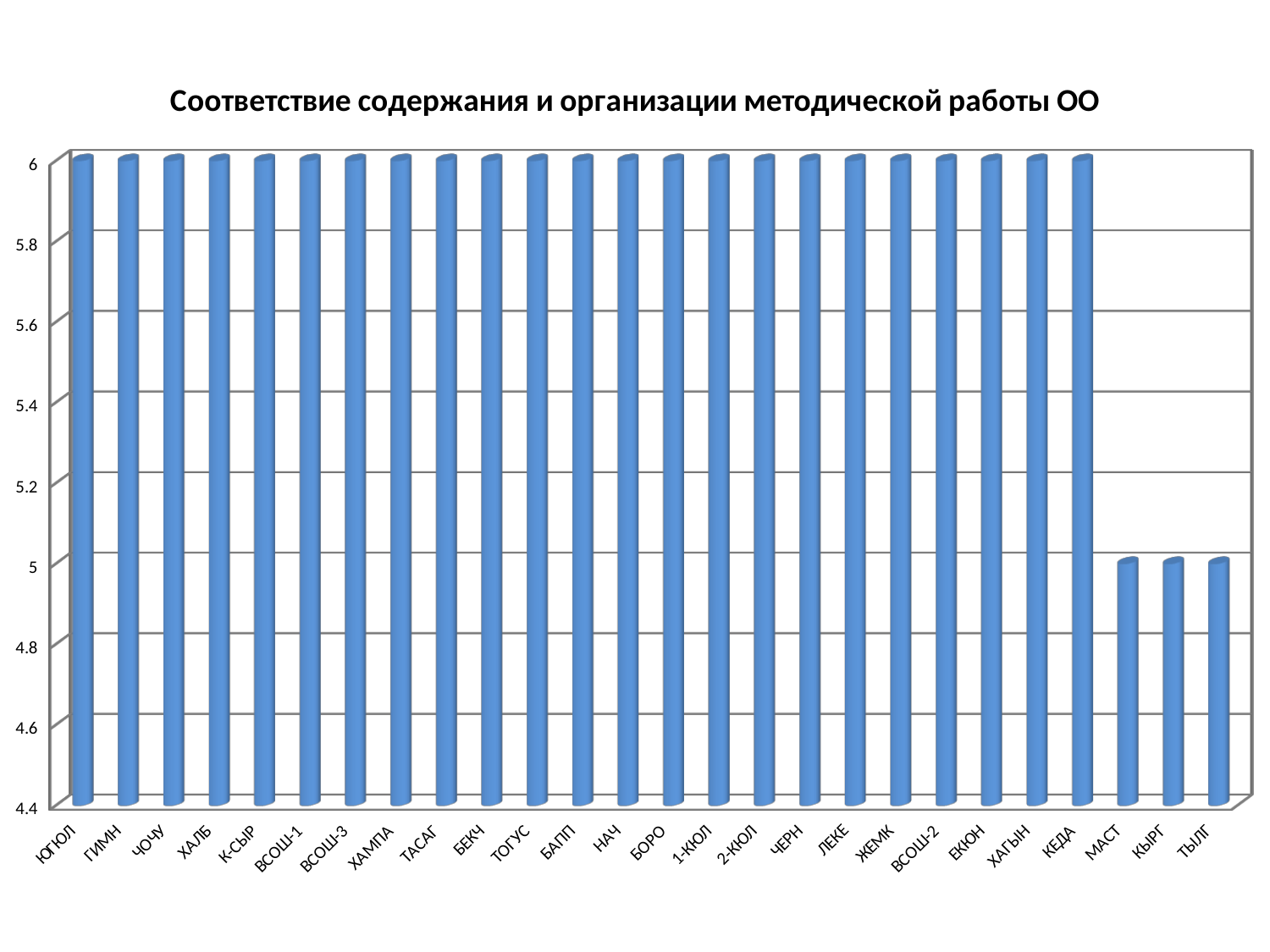
Is the value for БОРО greater or less than 5.8? greater Which is larger, the value for ХАГЫН or the value for КЫРГ? ХАГЫН What is the value for КЕДА? 6 How many categories are shown on the x axis? 26 How many categories have a value of 5? 3 Is the value for КЫРГ greater or less than 5.4? less What is the difference between the values for ЮГЮЛ and ТЫЛГ? 1 What kind of chart is this? bar chart What is the value for ТЫЛГ? 5 What is the value for ЮГЮЛ? 6 What is the value for МАСТ? 5 What is the title of the chart? Соответствие содержания и организации методической работы ОО